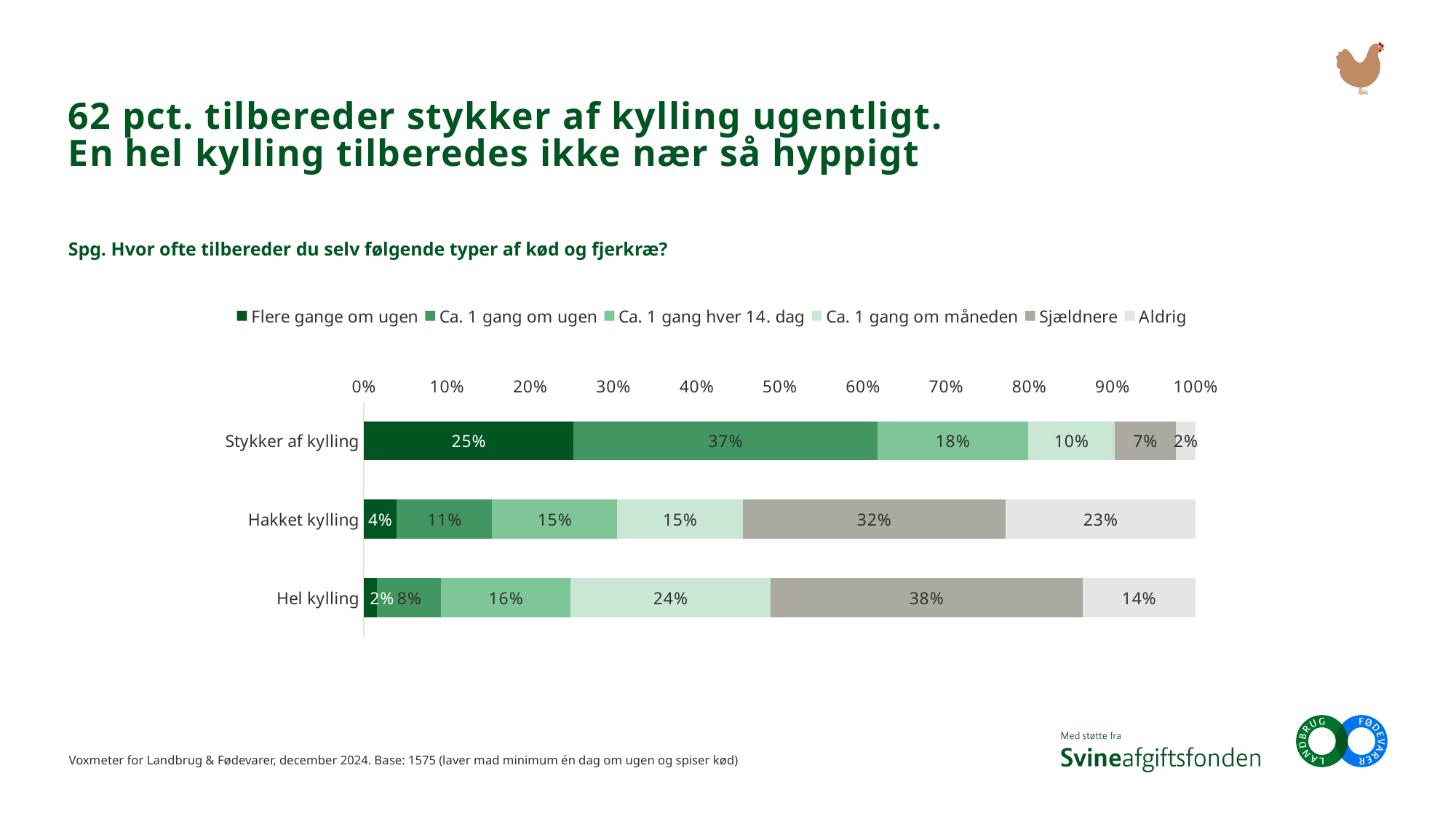
What is the value for 'Aldrig' for Hakket kylling? 23% Which is larger: the 'Aldrig' value for Hakket kylling or for Hel kylling? Hakket kylling Which category has the lowest value for 'Flere gange om ugen'? Hel kylling What is the difference between the 'Sjældnere' values for Hel kylling and Hakket kylling? 6% Which legend entry is shown in the darkest green? Flere gange om ugen What is the value for 'Flere gange om ugen' for Stykker af kylling? 25% What is the value for 'Sjældnere' for Hel kylling? 38% How many series does the legend list? 6 What is the value for 'Ca. 1 gang om måneden' for Hel kylling? 24% Which category has the highest value for 'Ca. 1 gang om ugen'? Stykker af kylling What kind of chart is shown on the slide? Stacked bar chart How many categories are plotted on the chart? 3